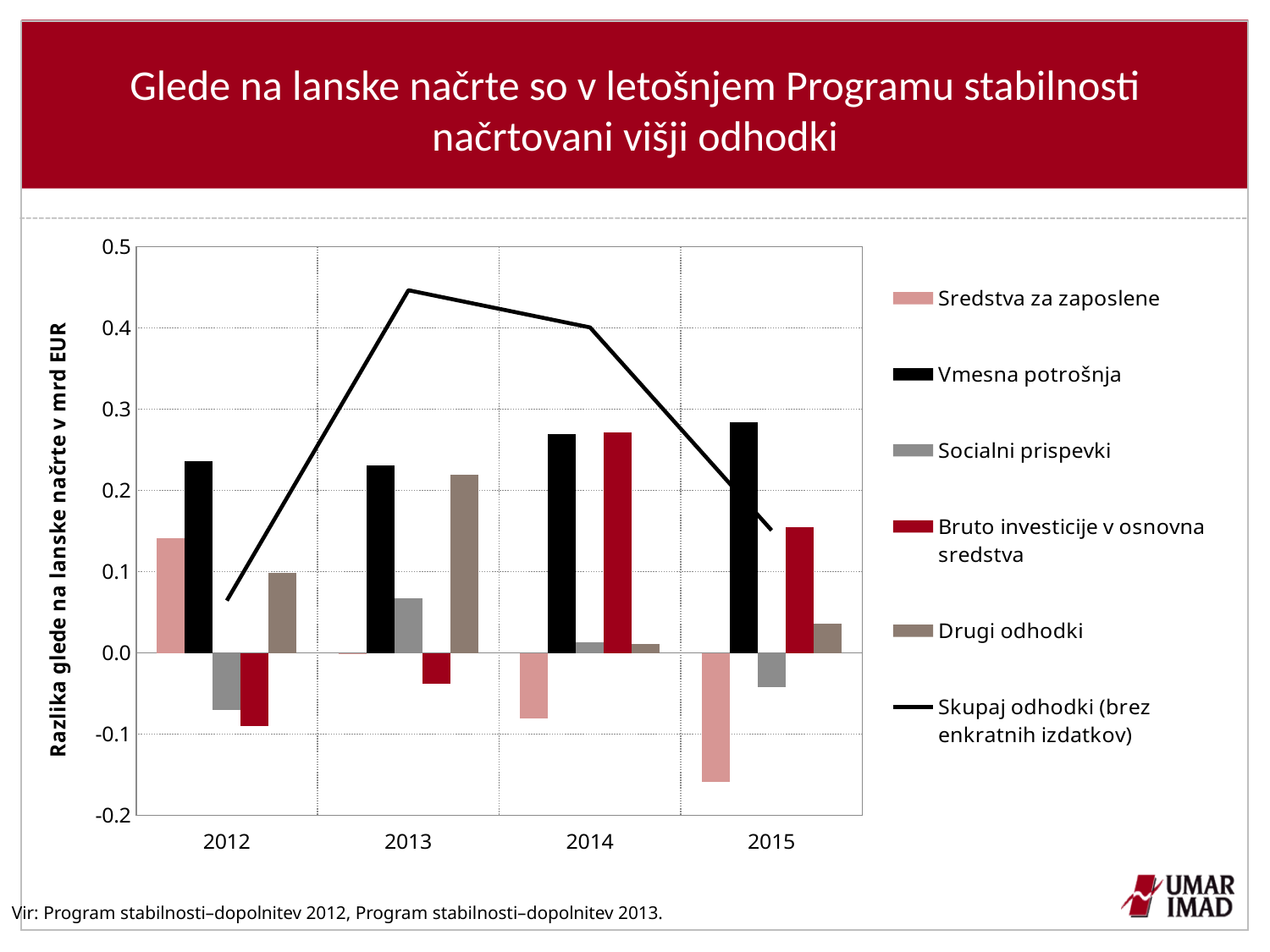
In which year does the Skupaj odhodki (brez enkratnih izdatkov) line reach its highest value? 2013 Is the value for Sredstva za zaposlene in 2015 greater or less than -0.1? less Does the Skupaj odhodki (brez enkratnih izdatkov) line rise or fall from 2013 to 2015? It falls Is the value for Vmesna potrošnja in 2015 greater or less than 0.2? greater Which series has the highest bar in 2012? Vmesna potrošnja How many series does the legend list? 6 In 2013, which is larger: Drugi odhodki or Socialni prispevki? Drugi odhodki How many years are shown on the x axis? 4 What kind of chart is this? Combined bar and line chart What is the label of the y axis? Razlika glede na lanske načrte v mrd EUR Is the value for Bruto investicije v osnovna sredstva in 2014 greater or less than 0.2? greater In which year is the Sredstva za zaposlene bar lowest? 2015